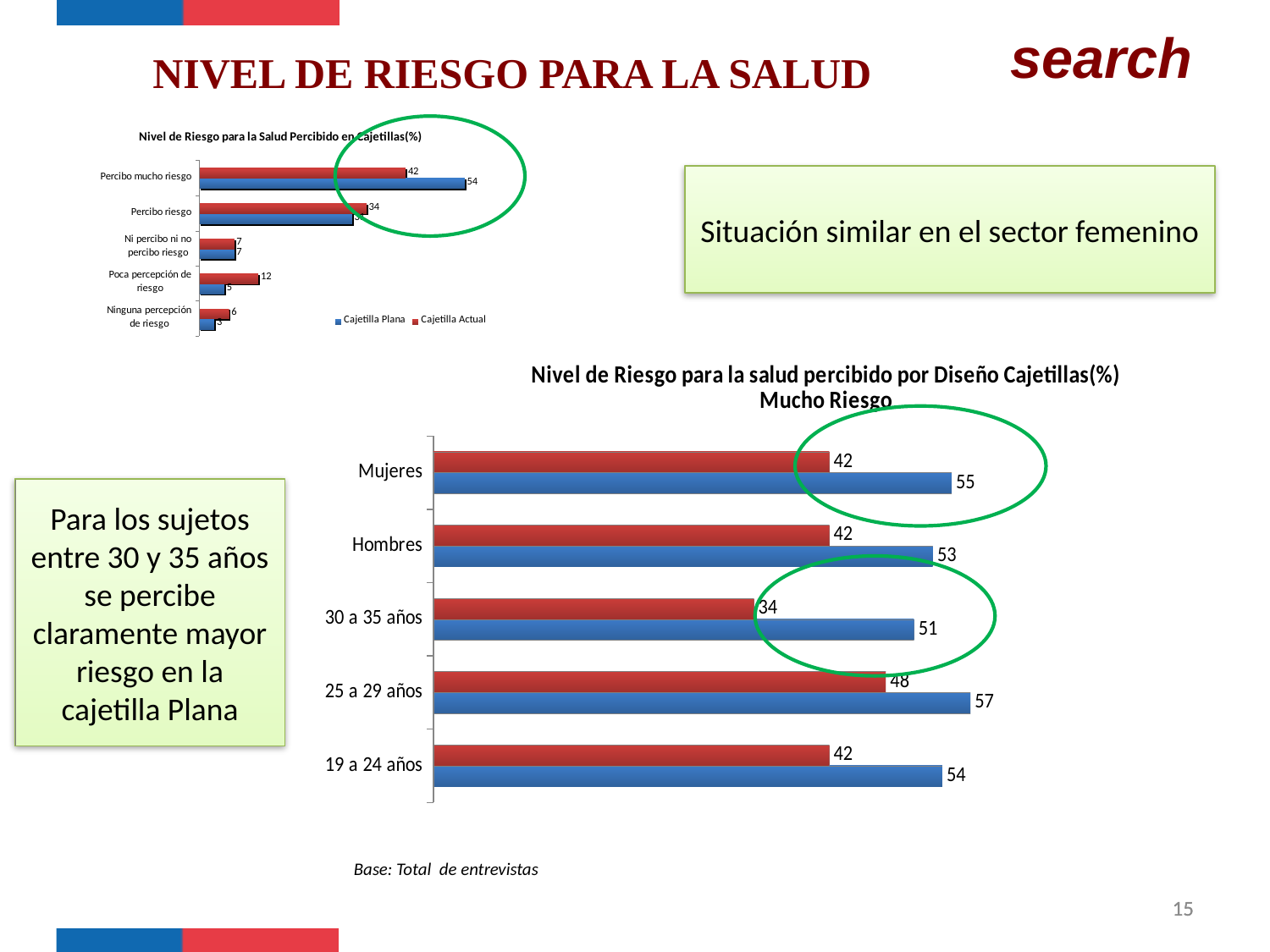
How many series does the legend of the small chart 'Nivel de Riesgo para la Salud Percibido en Cajetillas(%)' list? 2 What type of chart is the large chart 'Nivel de Riesgo para la salud percibido por Diseño Cajetillas(%) Mucho Riesgo'? bar chart In the large chart 'Nivel de Riesgo para la salud percibido por Diseño Cajetillas(%) Mucho Riesgo', what is the difference between the blue and red bars for 30 a 35 años? 17 In the large chart 'Nivel de Riesgo para la salud percibido por Diseño Cajetillas(%) Mucho Riesgo', what is the value of the blue bar for Mujeres? 55 In the large chart 'Nivel de Riesgo para la salud percibido por Diseño Cajetillas(%) Mucho Riesgo', which category has the lowest red bar? 30 a 35 años In the large chart 'Nivel de Riesgo para la salud percibido por Diseño Cajetillas(%) Mucho Riesgo', which is larger for Hombres, the blue bar or the red bar? the blue bar In the small chart 'Nivel de Riesgo para la Salud Percibido en Cajetillas(%)', what is the value for Cajetilla Plana in the category Percibo mucho riesgo? 54 In the small chart 'Nivel de Riesgo para la Salud Percibido en Cajetillas(%)', what is the value for Cajetilla Actual in the category Poca percepción de riesgo? 12 In the large chart 'Nivel de Riesgo para la salud percibido por Diseño Cajetillas(%) Mucho Riesgo', what is the value of the red bar for 30 a 35 años? 34 In the large chart 'Nivel de Riesgo para la salud percibido por Diseño Cajetillas(%) Mucho Riesgo', which category has the highest blue bar? 25 a 29 años How many categories are shown in the large chart 'Nivel de Riesgo para la salud percibido por Diseño Cajetillas(%) Mucho Riesgo'? 5 In the small chart 'Nivel de Riesgo para la Salud Percibido en Cajetillas(%)', which colour represents Cajetilla Actual? red